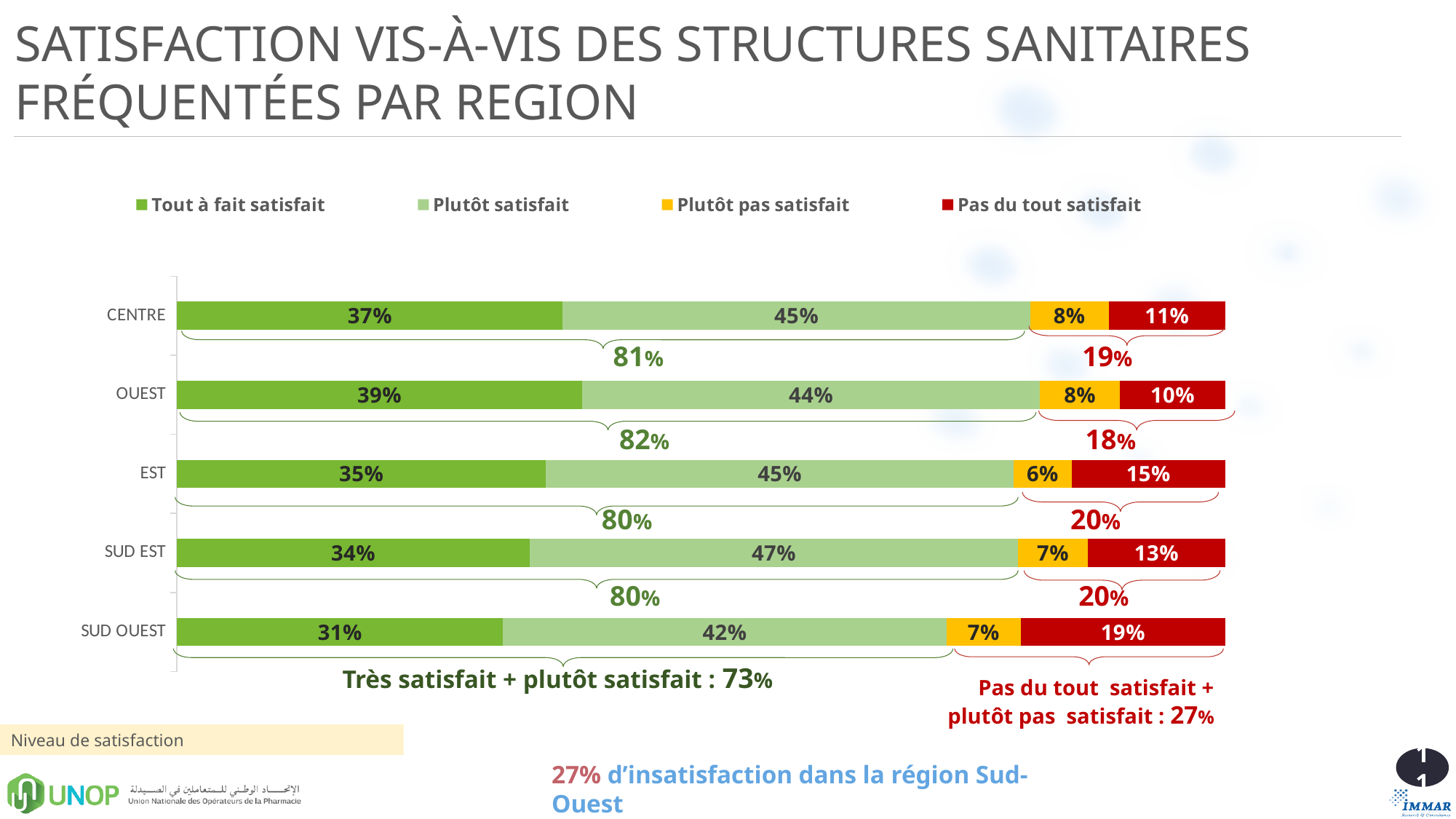
What is the difference between the "Plutôt satisfait" values for SUD EST and SUD OUEST? 5 percentage points What is the combined total of "Tout à fait satisfait" and "Plutôt satisfait" for the CENTRE region? 81% How many series does the legend list? 4 Which region has the lowest "Tout à fait satisfait" value? SUD OUEST Which is larger: the "Plutôt pas satisfait" value for CENTRE or for EST? CENTRE How many regions are shown in the chart? 5 What is the value of "Pas du tout satisfait" for the SUD OUEST region? 19% Which region has the highest "Tout à fait satisfait" value? OUEST Which region has the highest "Pas du tout satisfait" value? SUD OUEST What is the value of "Plutôt pas satisfait" for the EST region? 6% What is the value of "Tout à fait satisfait" for the OUEST region? 39% What kind of chart is shown on the slide? Stacked bar chart